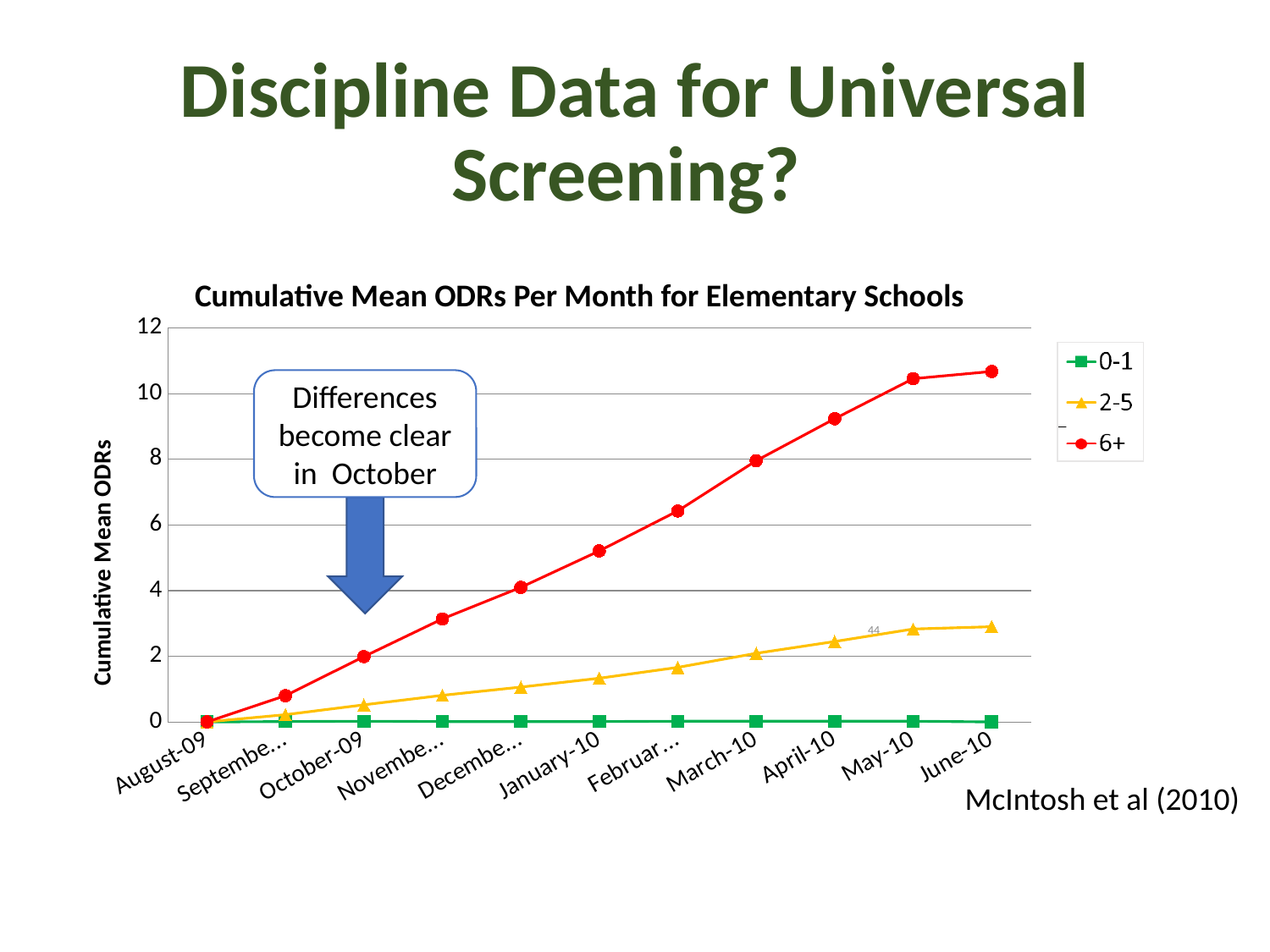
Which series has the lowest value in May-10? 0-1 Which series has the highest value in June-10? 6+ What kind of chart is shown on the slide? line chart What is the title of the chart? Cumulative Mean ODRs Per Month for Elementary Schools Does the 6+ series rise or fall from August-09 to June-10? rise How many months are plotted along the x axis? 11 Is the value for the 6+ series in June-10 greater or less than 10? greater What is the label of the y axis? Cumulative Mean ODRs Is the value for the 2-5 series in June-10 greater or less than 2? greater How many series does the legend list? 3 Is the value for the 6+ series in March-10 greater or less than 6? greater In March-10, which series has the larger value, 2-5 or 6+? 6+